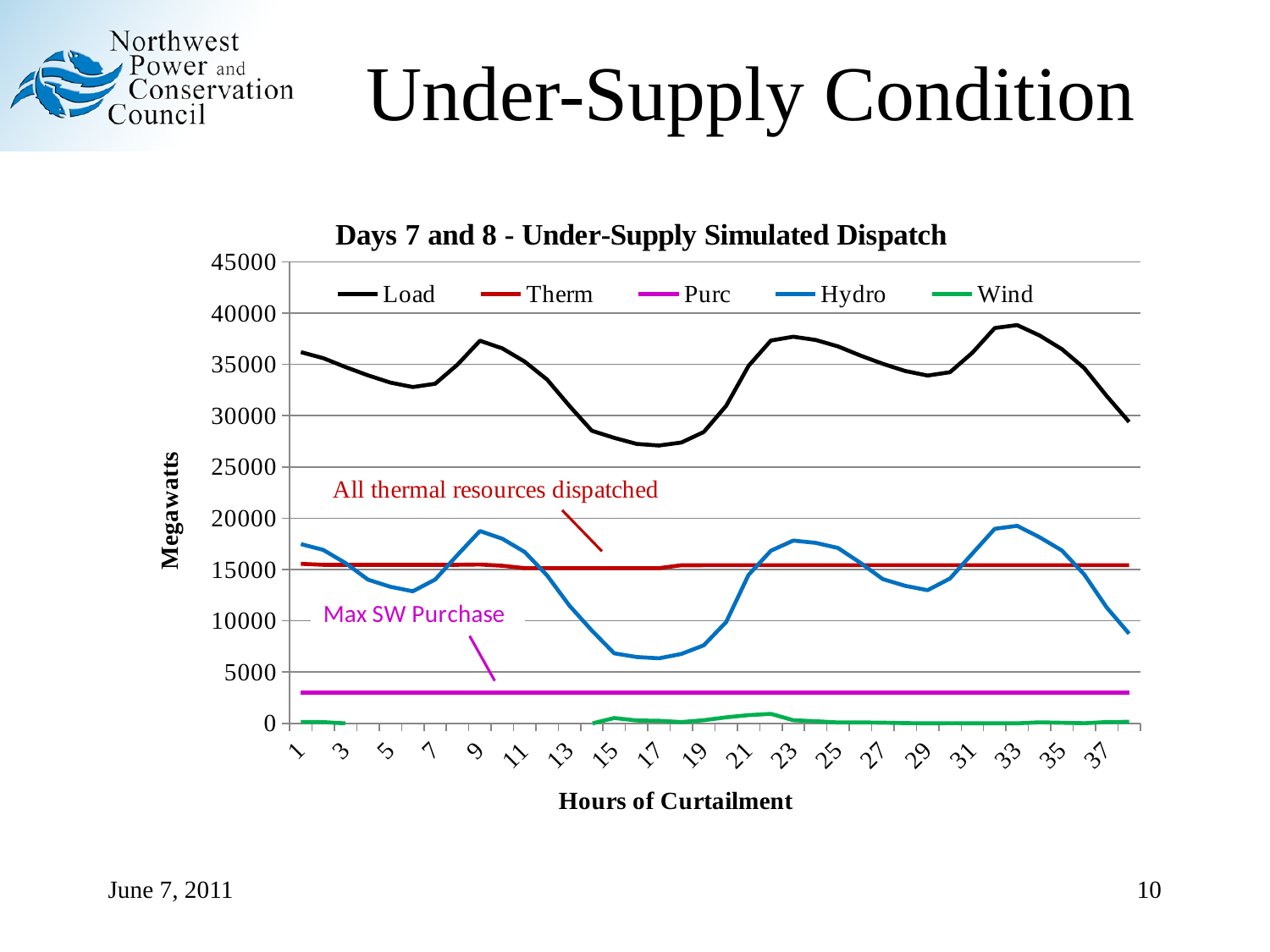
What is the title of the chart? Days 7 and 8 - Under-Supply Simulated Dispatch Does the Load series rise or fall between hour 9 and hour 17? fall What kind of chart is shown on the slide? line chart Which series has the lowest values across the chart? Wind Is the Load value at hour 17 greater or less than 30000? less Is the Hydro value at hour 17 greater or less than 10000? less What is the label of the vertical axis? Megawatts At hour 23, which is larger, Load or Hydro? Load How many series does the legend list? 5 Is the Purc value greater or less than 5000? less Which series has the highest values across the chart? Load